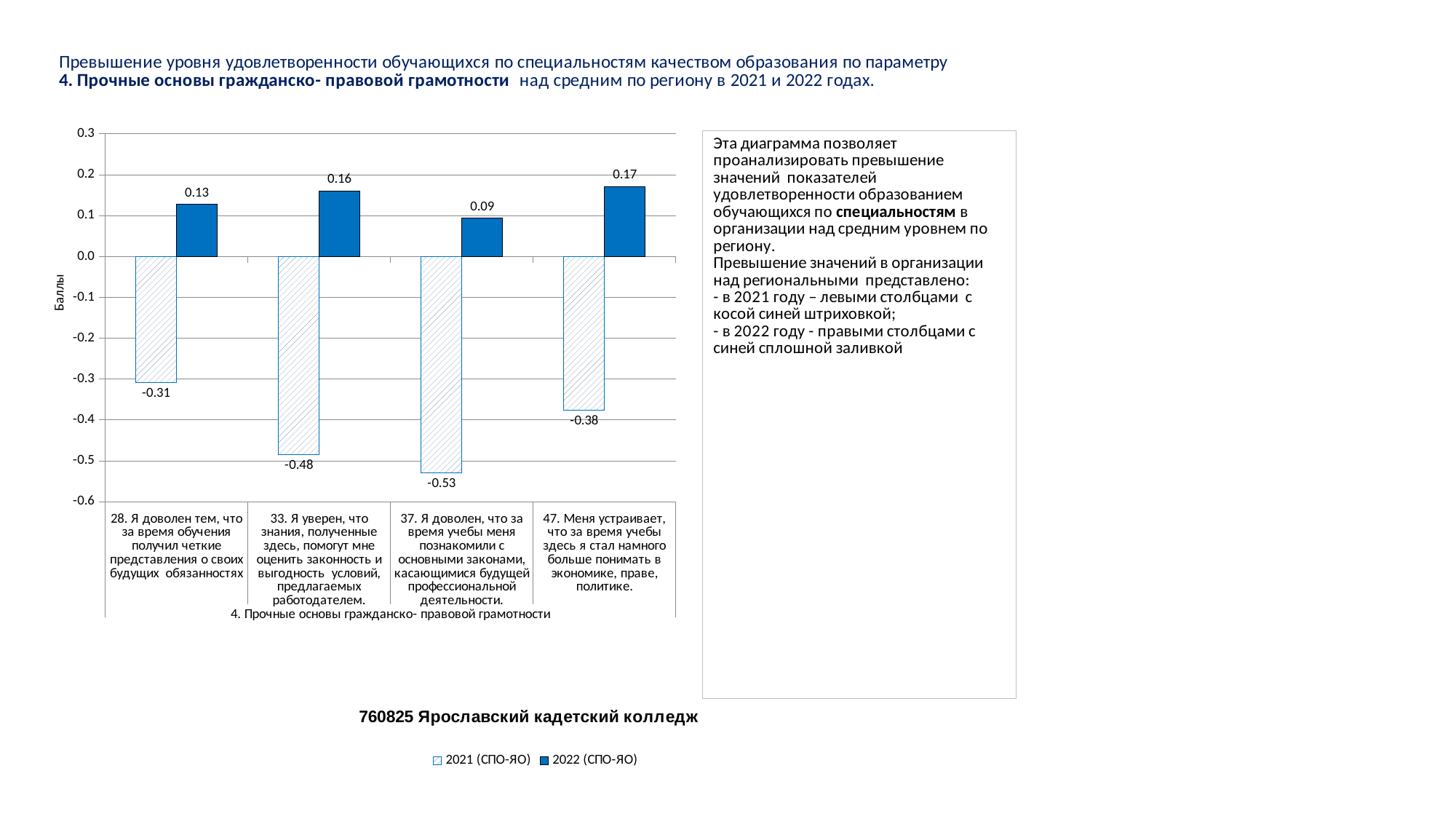
What kind of chart is shown on the slide? bar chart What is the value for 2021 (СПО-ЯО) for category 37 ("Я доволен, что за время учебы меня познакомили с основными законами...")? -0.53 What is the label of the vertical axis of the chart? Баллы How many categories are shown on the x axis of the chart? 4 Which category has the lowest value for the 2021 (СПО-ЯО) series? 37. Я доволен, что за время учебы меня познакомили с основными законами, касающимися будущей профессиональной деятельности. What is the value for 2022 (СПО-ЯО) for category 28 ("Я доволен тем, что за время обучения получил четкие представления о своих будущих обязанностях")? 0.13 Is the 2021 (СПО-ЯО) value for category 33 greater or less than -0.4? less Which is larger for category 28: the 2022 (СПО-ЯО) value or the 2021 (СПО-ЯО) value? 2022 (СПО-ЯО) What is the difference between the 2022 (СПО-ЯО) and 2021 (СПО-ЯО) values for category 33? 0.64 What is the value for 2021 (СПО-ЯО) for category 47 ("Меня устраивает, что за время учебы здесь я стал намного больше понимать в экономике, праве, политике")? -0.38 How many series does the legend list? 2 Which category has the highest value for the 2022 (СПО-ЯО) series? 47. Меня устраивает, что за время учебы здесь я стал намного больше понимать в экономике, праве, политике.